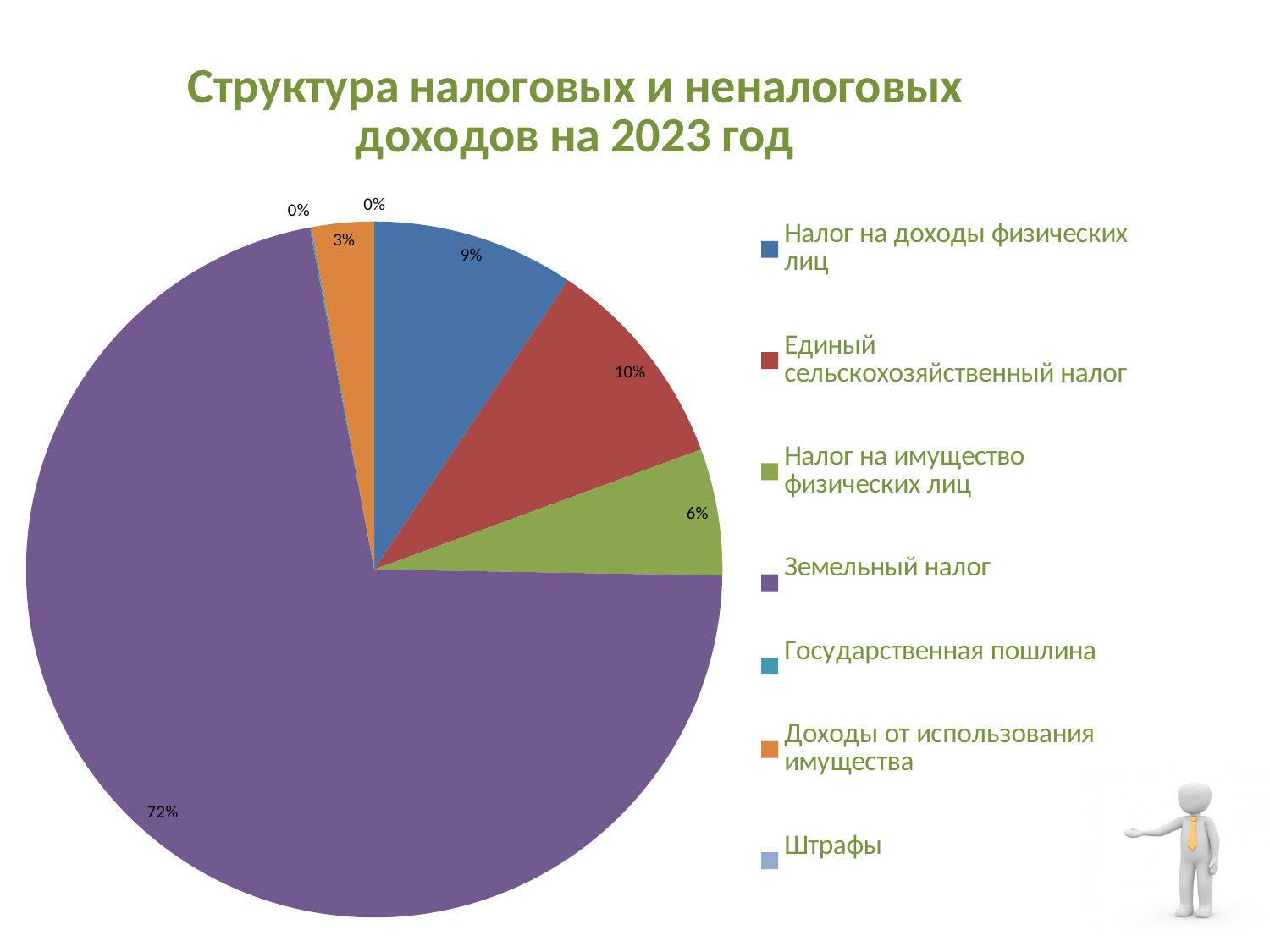
What share of the pie is Налог на доходы физических лиц? 9% What share of the pie is Доходы от использования имущества? 3% What is the title of the chart? Структура налоговых и неналоговых доходов на 2023 год What share of the pie is Налог на имущество физических лиц? 6% What colour is the slice for Земельный налог? Purple Which category has the largest slice of the pie? Земельный налог Which is larger, Единый сельскохозяйственный налог or Налог на имущество физических лиц? Единый сельскохозяйственный налог What is the difference between the share of Земельный налог and the share of Единый сельскохозяйственный налог? 62% How many entries does the legend list? 7 What kind of chart is shown on the slide? Pie chart